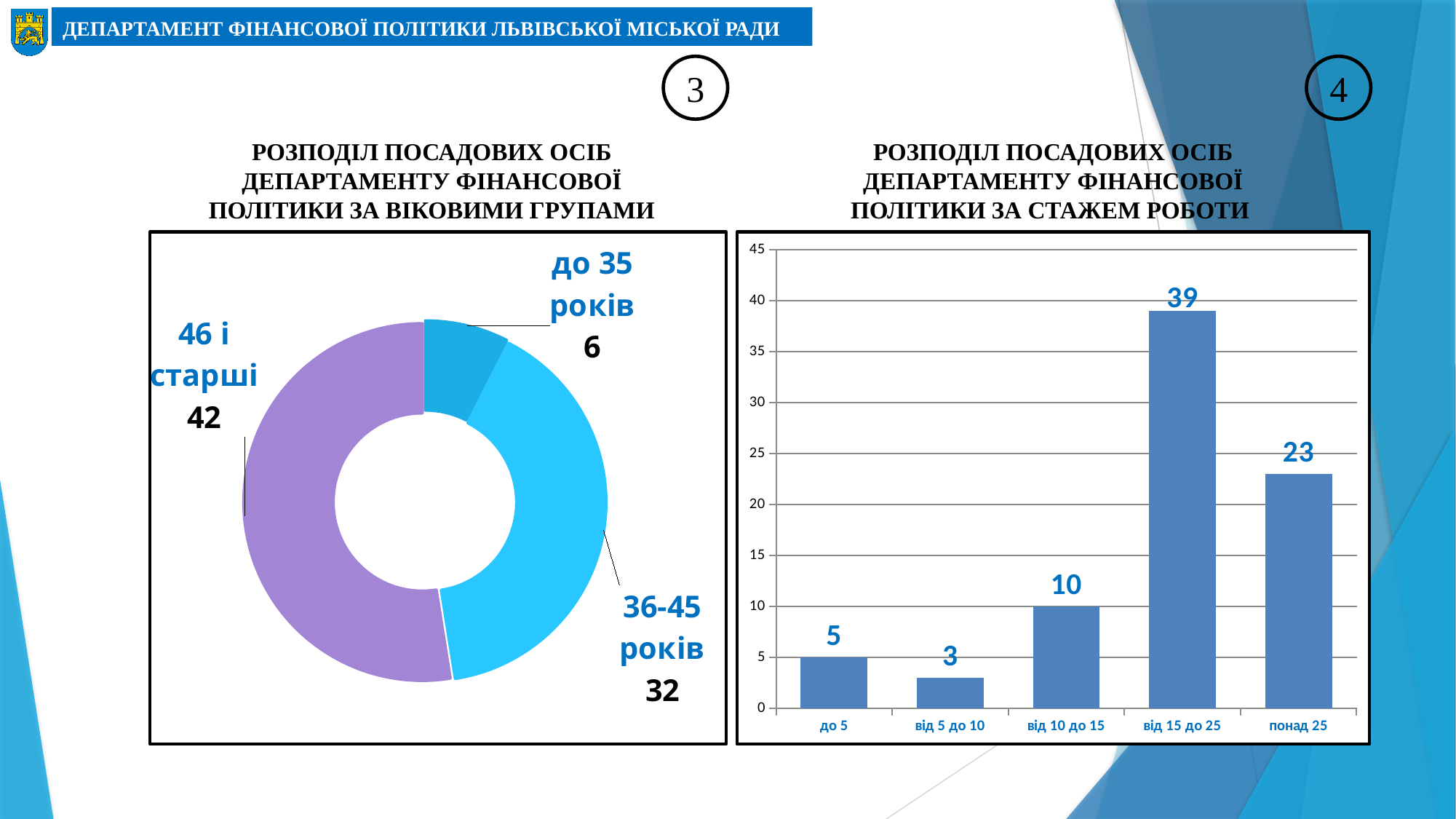
In the left chart (age groups), what share of the total does the '36-45 років' group represent? 40% In the left chart (age groups), what is the difference between the '46 і старші' and '36-45 років' values? 10 In the right chart (work experience), which category has the lowest value? від 5 до 10 In the left chart (РОЗПОДІЛ ПОСАДОВИХ ОСІБ ... ЗА ВІКОВИМИ ГРУПАМИ), what is the value for the '36-45 років' group? 32 In the right chart (work experience), which is larger: 'до 5' or 'від 10 до 15'? від 10 до 15 In the right chart (work experience), how many categories are shown on the x axis? 5 In the right chart (work experience), what is the difference between 'від 15 до 25' and 'понад 25'? 16 What type of chart is the right chart (work experience)? Bar chart What type of chart is the left chart (age groups)? Doughnut (pie) chart In the right chart (РОЗПОДІЛ ПОСАДОВИХ ОСІБ ... ЗА СТАЖЕМ РОБОТИ), what is the value for 'від 15 до 25'? 39 In the left chart (age groups), which age group has the largest value? 46 і старші In the left chart (age groups), which age group has the smallest value? до 35 років